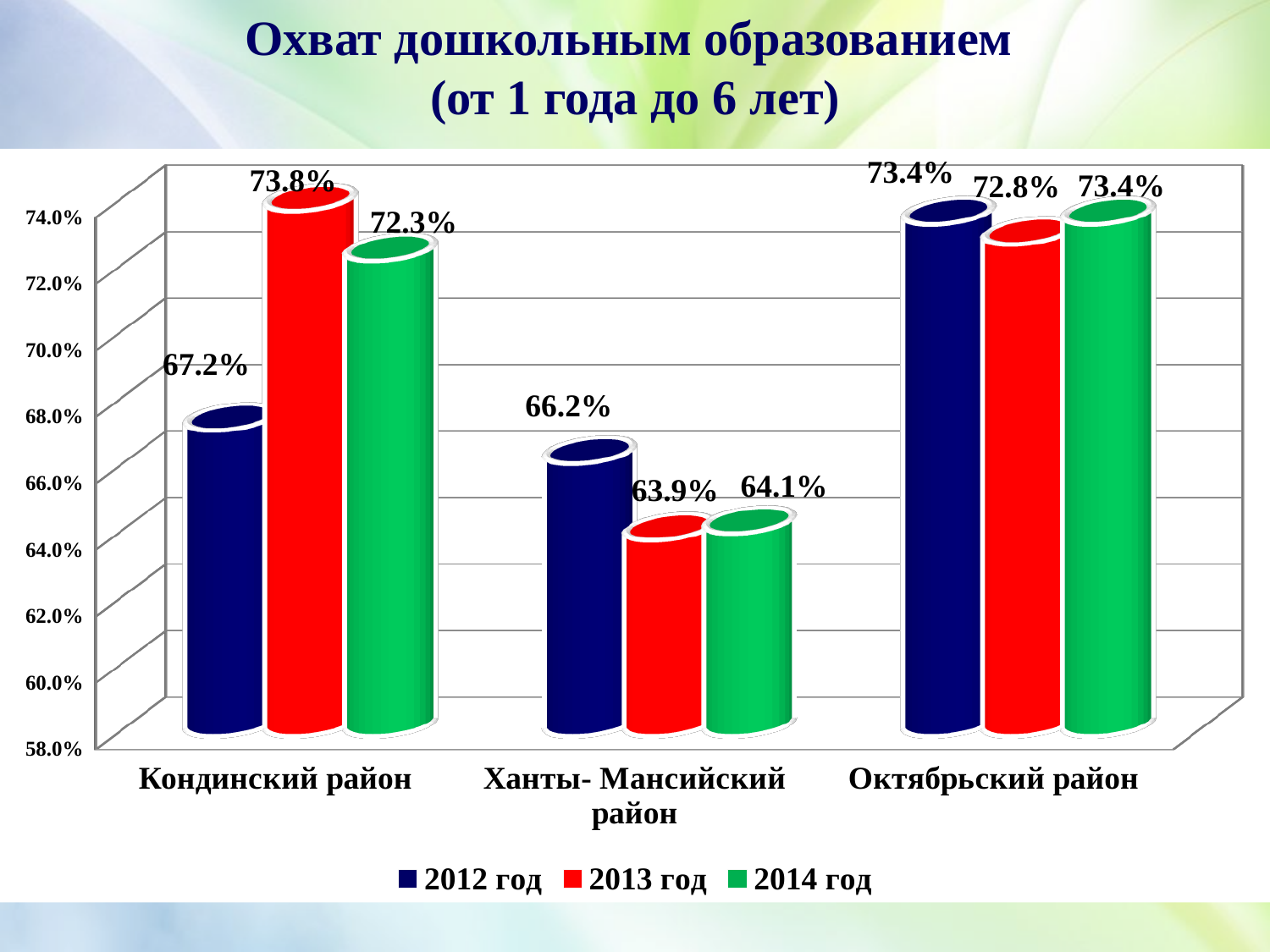
How many districts are shown on the x axis? 3 Which district has the highest value in 2012 год? Октябрьский район What kind of chart is shown on the slide? Bar chart What is the difference between the 2013 год and 2012 год values for Кондинский район? 6.6% What is the title of the chart? Охват дошкольным образованием (от 1 года до 6 лет) What is the value for Ханты-Мансийский район in 2013 год? 63.9% Which district has the lowest value in 2014 год? Ханты-Мансийский район Which is larger for Ханты-Мансийский район: the 2012 год value or the 2014 год value? 2012 год What is the value for Кондинский район in 2013 год? 73.8% What is the value for Ханты-Мансийский район in 2012 год? 66.2% What is the value for Октябрьский район in 2014 год? 73.4% How many series does the legend list? 3